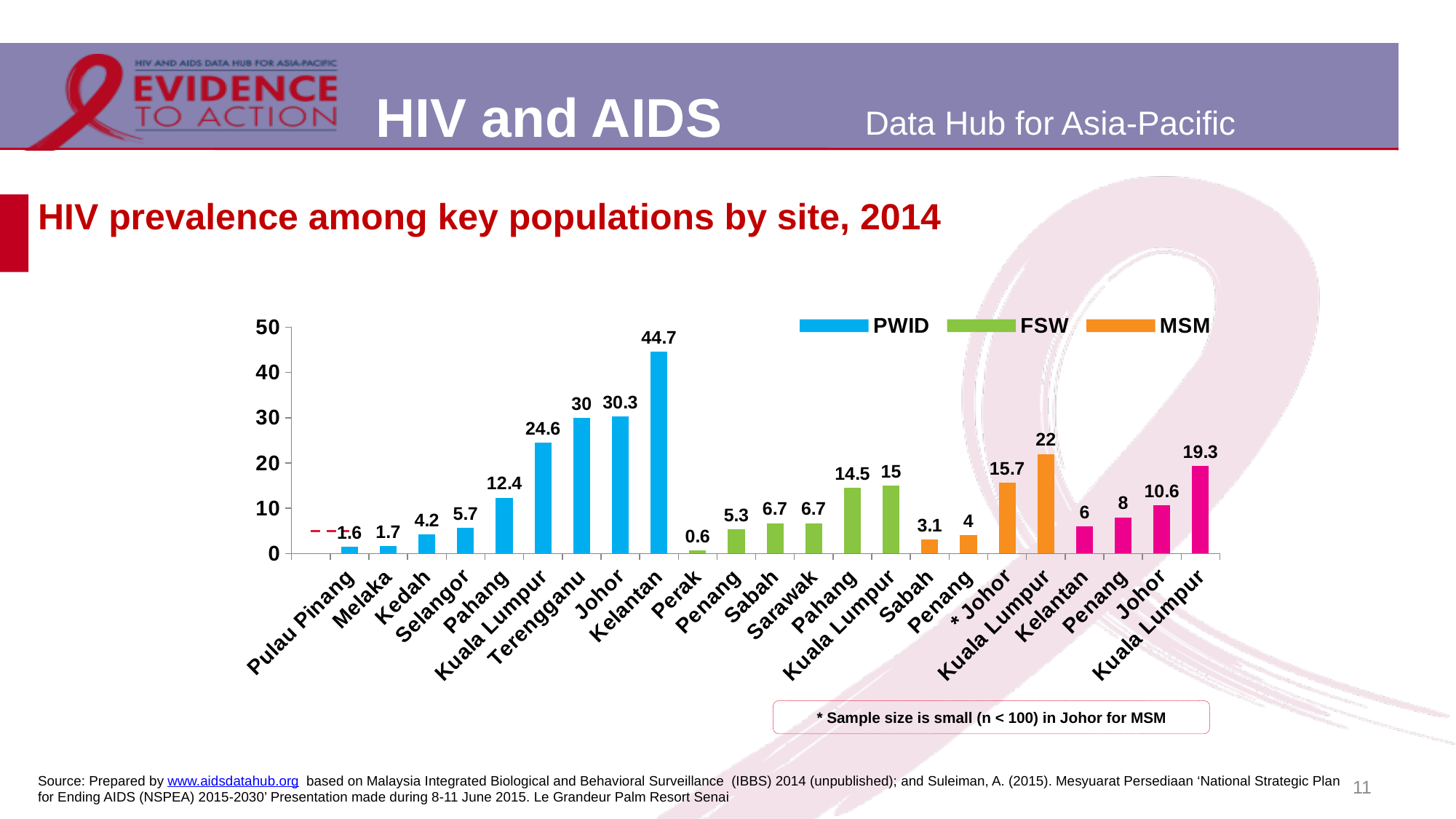
Which site has the lowest HIV prevalence among FSW? Perak How many series does the legend list? 3 What is the HIV prevalence among FSW in Kuala Lumpur? 15 What is the difference between the MSM prevalence in Kuala Lumpur and in Johor? 6.3 Which series is shown in orange in the legend? MSM What kind of chart is shown on the slide? Bar chart What is the difference between the PWID prevalence in Johor and in Terengganu? 0.3 Which is larger: the MSM prevalence in Kuala Lumpur or the PWID prevalence in Kuala Lumpur? PWID prevalence in Kuala Lumpur Which site has the highest HIV prevalence among PWID? Kelantan Is the PWID prevalence in Kelantan greater or less than 40? greater What is the HIV prevalence among MSM in Kuala Lumpur? 22 What is the HIV prevalence among PWID in Kelantan? 44.7